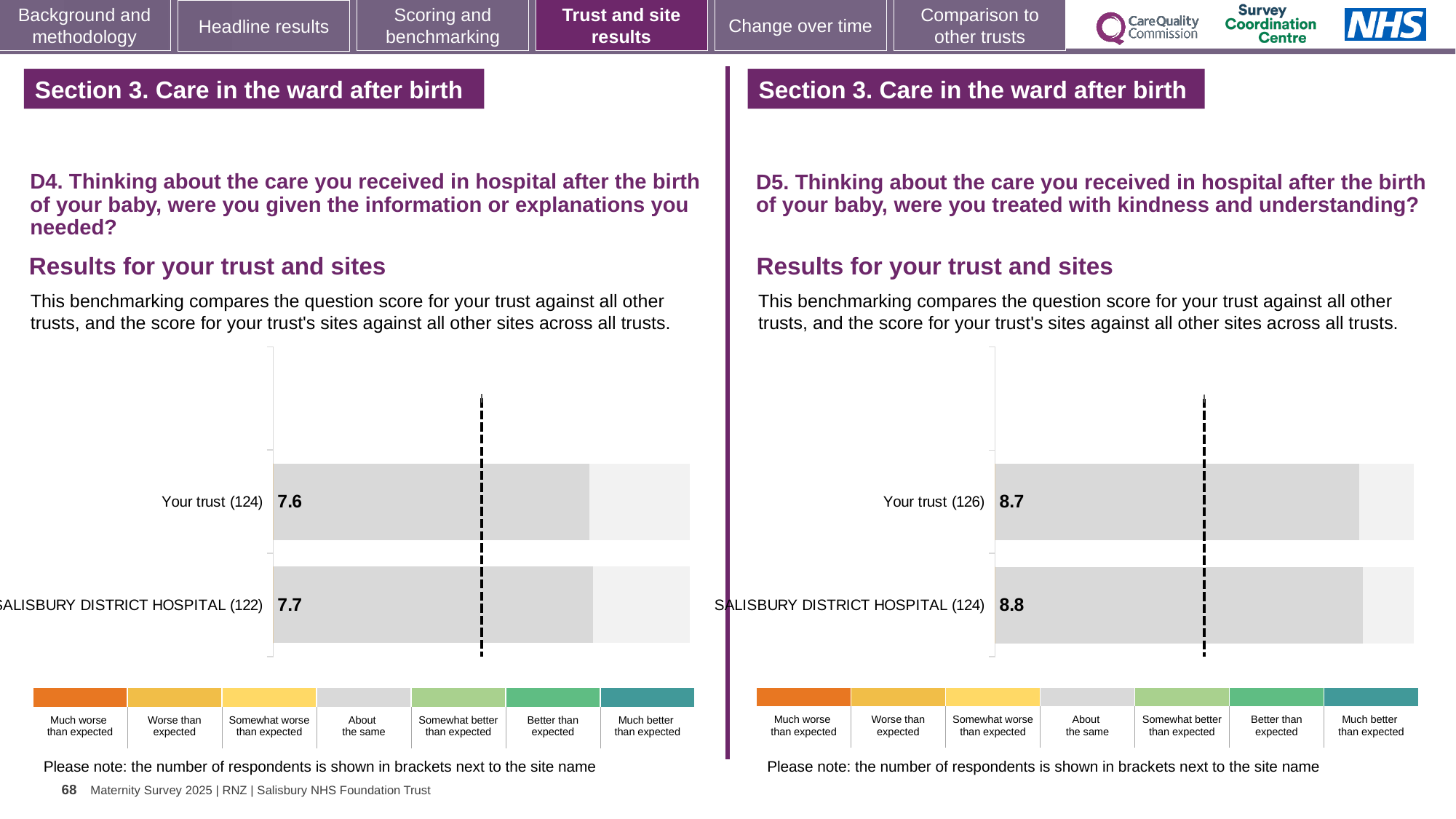
How many categories does the colour legend below the D4 chart on the left list? 7 How many bars are plotted in the D4 chart on the left? 2 In the D4 chart on the left, what is the score for Salisbury District Hospital? 7.7 In the D4 chart on the left, how many respondents are shown in brackets for Your trust? 124 In the D5 chart on the right, which benchmarking category does the grey colour of the bars correspond to in the legend? About the same In the D5 chart on the right, how many respondents are shown in brackets for Salisbury District Hospital? 124 In the D4 chart on the left, what is the score for Your trust? 7.6 In the D5 chart on the right, what is the score for Salisbury District Hospital? 8.8 In the D4 chart on the left, what is the difference between the Salisbury District Hospital score and the Your trust score? 0.1 In the D5 chart on the right, what is the score for Your trust? 8.7 In the D5 chart on the right, what is the difference between the Salisbury District Hospital score and the Your trust score? 0.1 What kind of chart is used in the D5 chart on the right? Bar chart